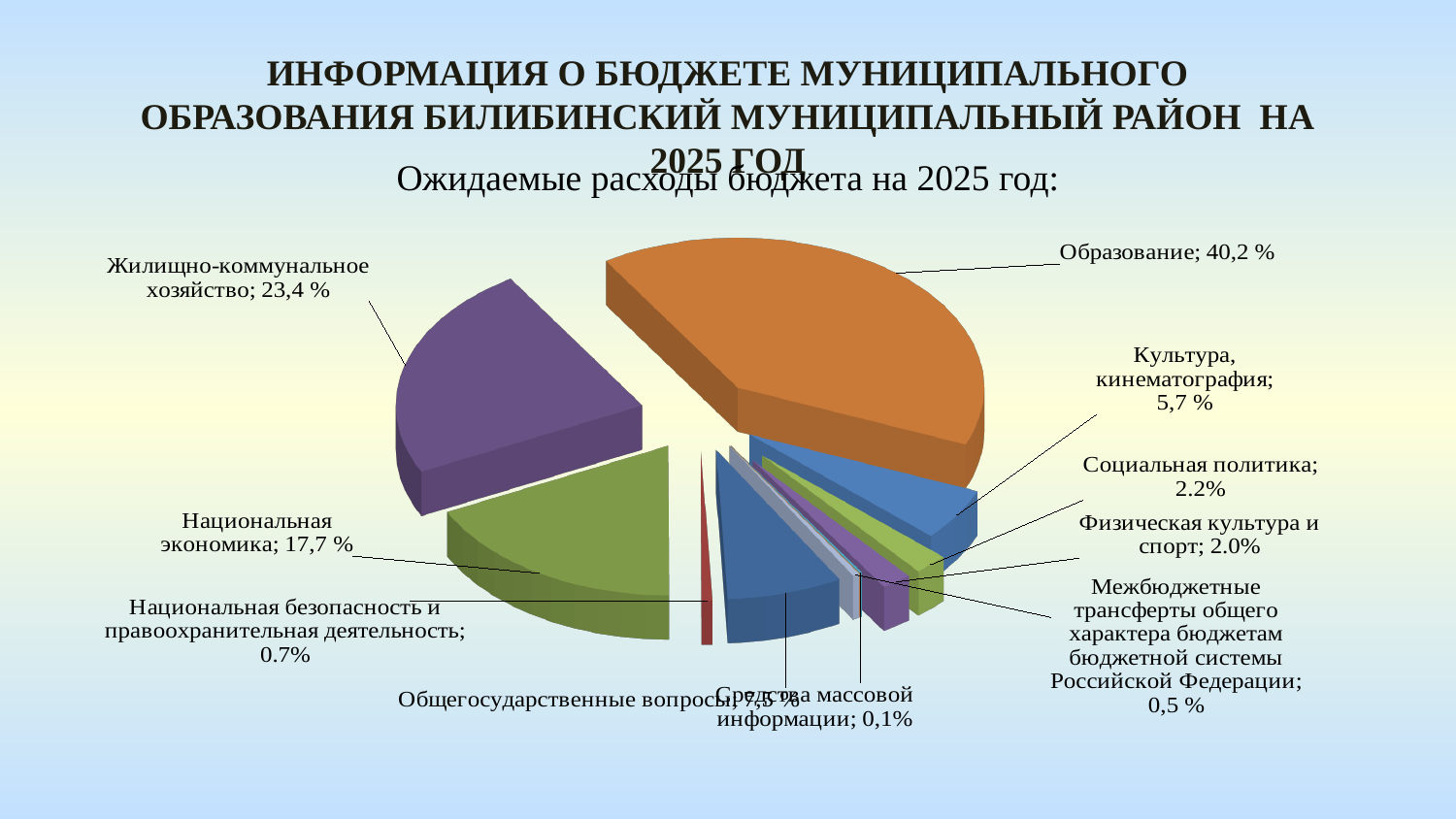
What share of expected 2025 budget expenditures goes to Культура, кинематография? 5,7 % What share of expected 2025 budget expenditures goes to Национальная экономика? 17,7 % Which category has the largest share of expected 2025 budget expenditures? Образование What share of expected 2025 budget expenditures goes to Образование? 40,2 % Which has a larger share of expected 2025 expenditures: Жилищно-коммунальное хозяйство or Национальная экономика? Жилищно-коммунальное хозяйство What share of expected 2025 budget expenditures goes to Средства массовой информации? 0,1% Which category has the smallest share of expected 2025 budget expenditures? Средства массовой информации What share of expected 2025 budget expenditures goes to Жилищно-коммунальное хозяйство? 23,4 % What kind of chart is shown on the slide? Pie chart What share of expected 2025 budget expenditures goes to Социальная политика? 2.2% What is the difference in percentage points between the shares of Образование and Жилищно-коммунальное хозяйство? 16,8 How many expenditure categories are shown in the pie chart? 10